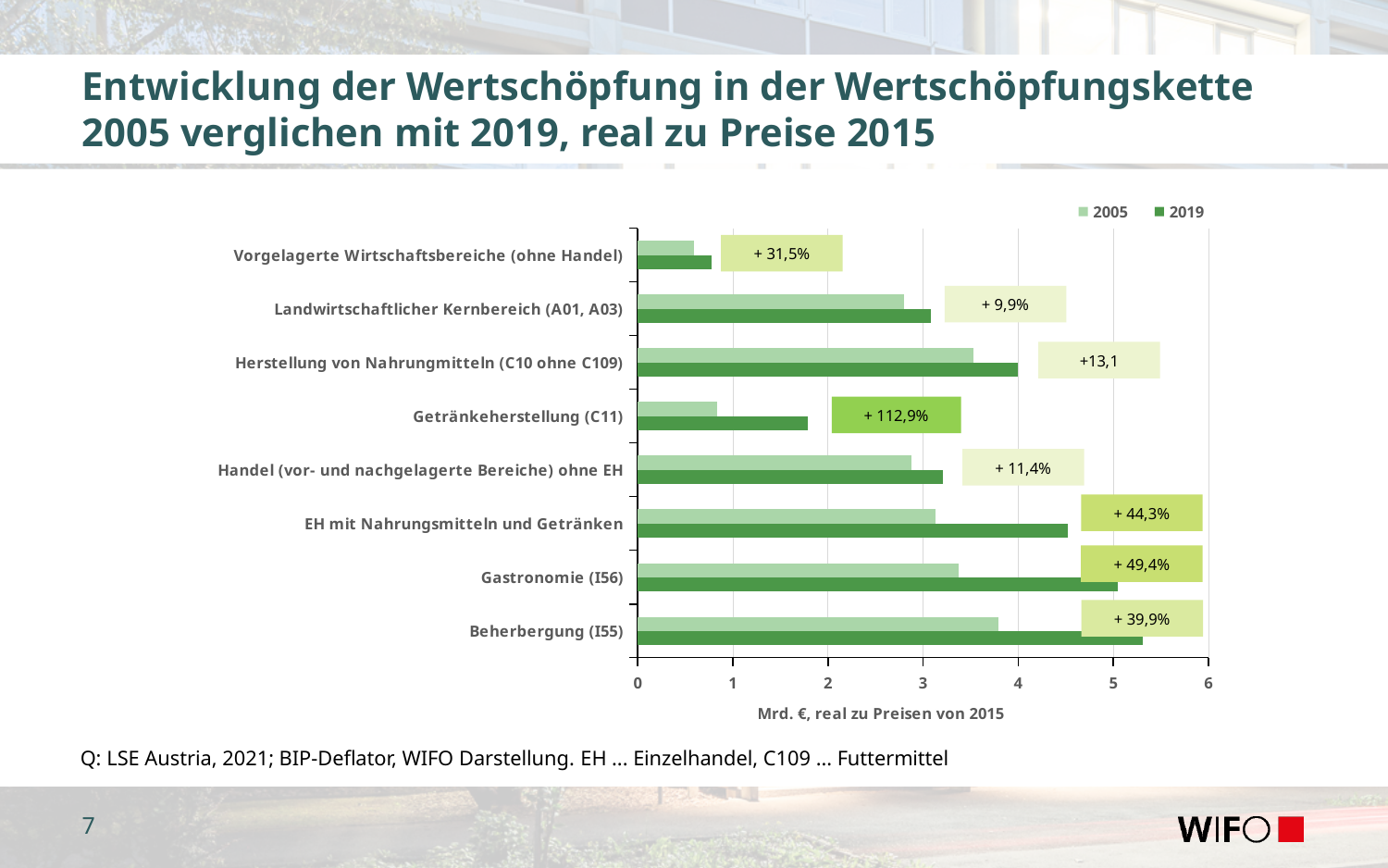
Which category shows the smallest printed percentage increase? Landwirtschaftlicher Kernbereich (A01, A03) Which category has the longest 2019 bar? Beherbergung (I55) How many series does the legend list? 2 What percentage change is printed next to the bars for Getränkeherstellung (C11)? + 112,9% Which category shows the largest printed percentage increase? Getränkeherstellung (C11) How many categories are plotted on the chart? 8 What percentage change is printed next to the bars for Gastronomie (I56)? + 49,4% What percentage change is printed next to the bars for Landwirtschaftlicher Kernbereich (A01, A03)? + 9,9% Is the 2019 value for Beherbergung (I55) greater or less than 5? greater Which is larger, the 2019 value for Gastronomie (I56) or the 2019 value for EH mit Nahrungsmitteln und Getränken? Gastronomie (I56) Is the 2005 value for Getränkeherstellung (C11) greater or less than 1? less What kind of chart is shown on the slide? bar chart